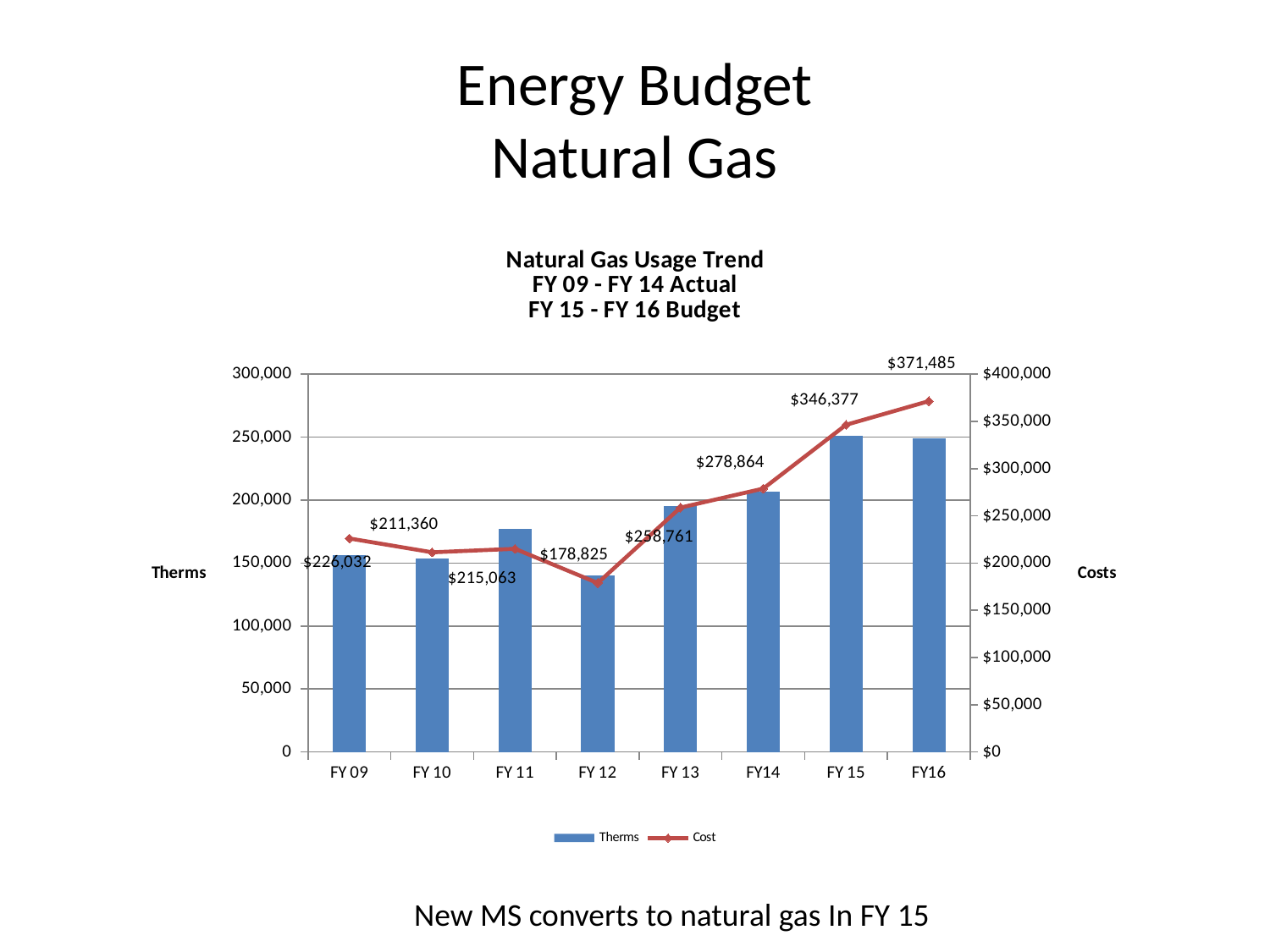
How many fiscal years are shown on the x axis? 8 Which fiscal year has the highest cost? FY16 Does the cost rise or fall from FY 12 to FY16? rise Is the Therms value for FY 12 greater or less than 150,000? less How many series does the legend list? 2 What is the cost value shown for FY 12? $178,825 What is the cost value shown for FY 15? $346,377 What is the difference between the cost for FY16 and the cost for FY 15? $25,108 Which is larger, the cost for FY 09 or the cost for FY 10? FY 09 Which fiscal year has the lowest cost? FY 12 What is the cost value shown for FY16? $371,485 Is the Therms value for FY 15 greater or less than 200,000? greater